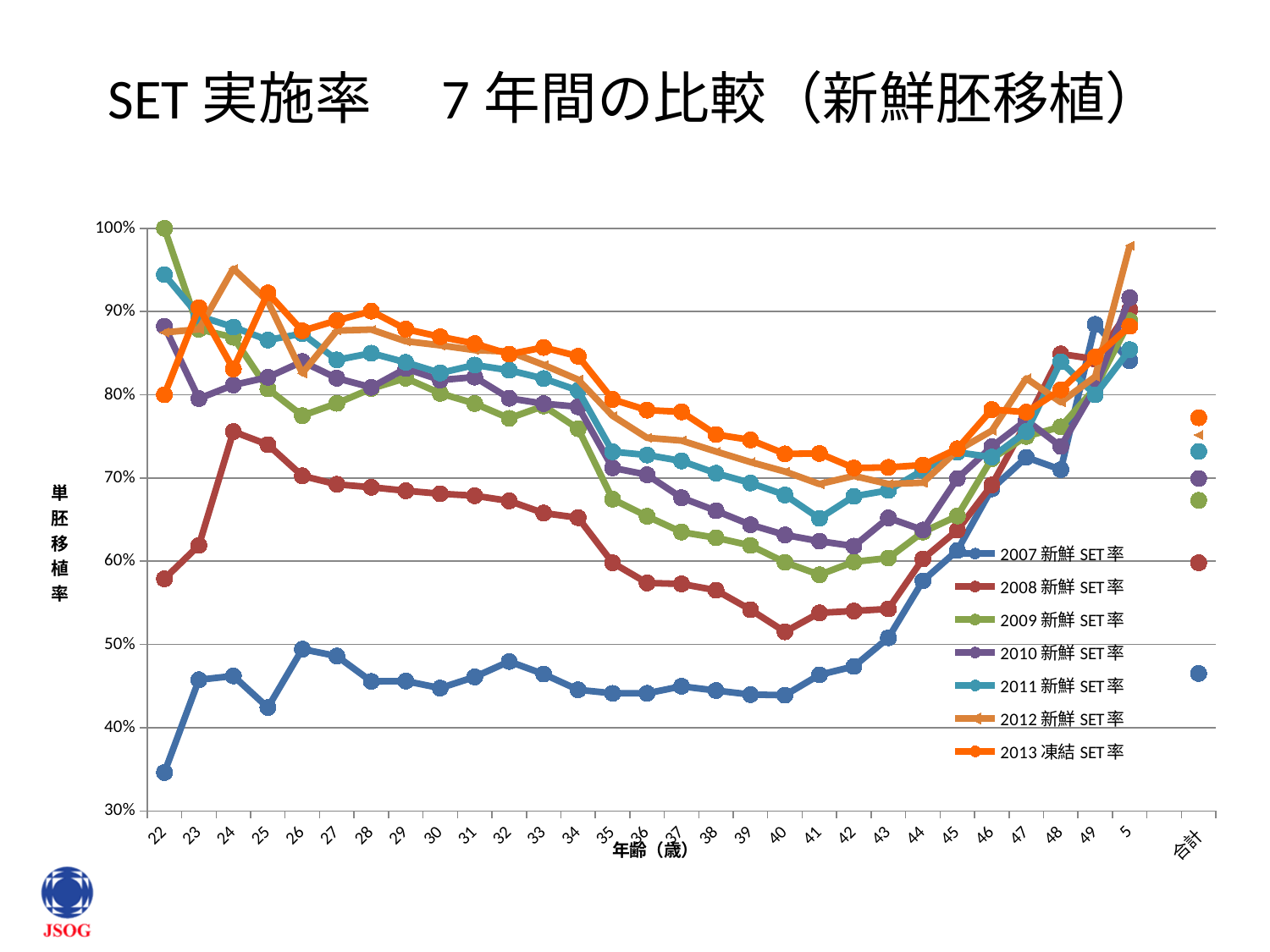
Which series has the lowest value at age 30? 2007 新鮮 SET 率 Which series has the highest value at age 22? 2009 新鮮 SET 率 What is the value of the 2009 新鮮 SET 率 series at age 22? 100% What is the title of the slide's chart? SET 実施率 7 年間の比較（新鮮胚移植） Does the 2007 新鮮 SET 率 series rise or fall from age 40 to age 49? rise What kind of chart is shown on the slide? line chart Is the value for 2008 新鮮 SET 率 at age 24 greater or less than 70%? greater How many series does the legend list? 7 Which series has the lowest value at age 22? 2007 新鮮 SET 率 Is the value for 2007 新鮮 SET 率 at age 22 greater or less than 40%? less At age 40, which is larger: the 2007 新鮮 SET 率 value or the 2008 新鮮 SET 率 value? 2008 新鮮 SET 率 Is the value for 2007 新鮮 SET 率 at 合計 greater or less than 50%? less